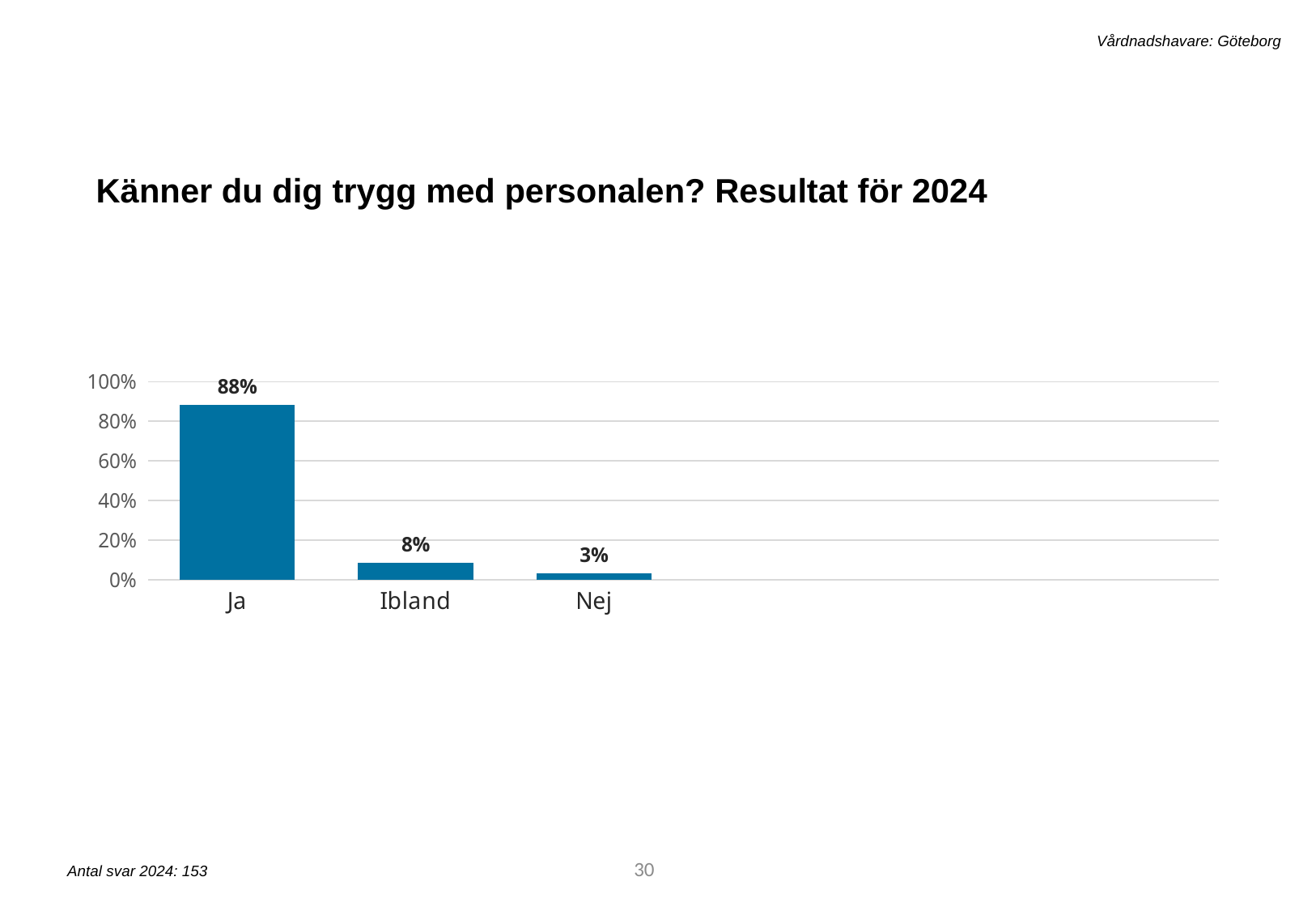
What is the title of the chart on the slide? Känner du dig trygg med personalen? Resultat för 2024 What is the value for Nej? 3% What kind of chart is shown on the slide? bar chart What is the value for Ja? 88% What is the difference between the values for Ibland and Nej? 5% How many categories are shown on the x axis? 3 What is the value for Ibland? 8% Which category has the highest value? Ja Is the value for Ja greater or less than 80%? greater Which is larger, the value for Ibland or the value for Nej? Ibland What is the difference between the values for Ja and Ibland? 80% Which category has the lowest value? Nej